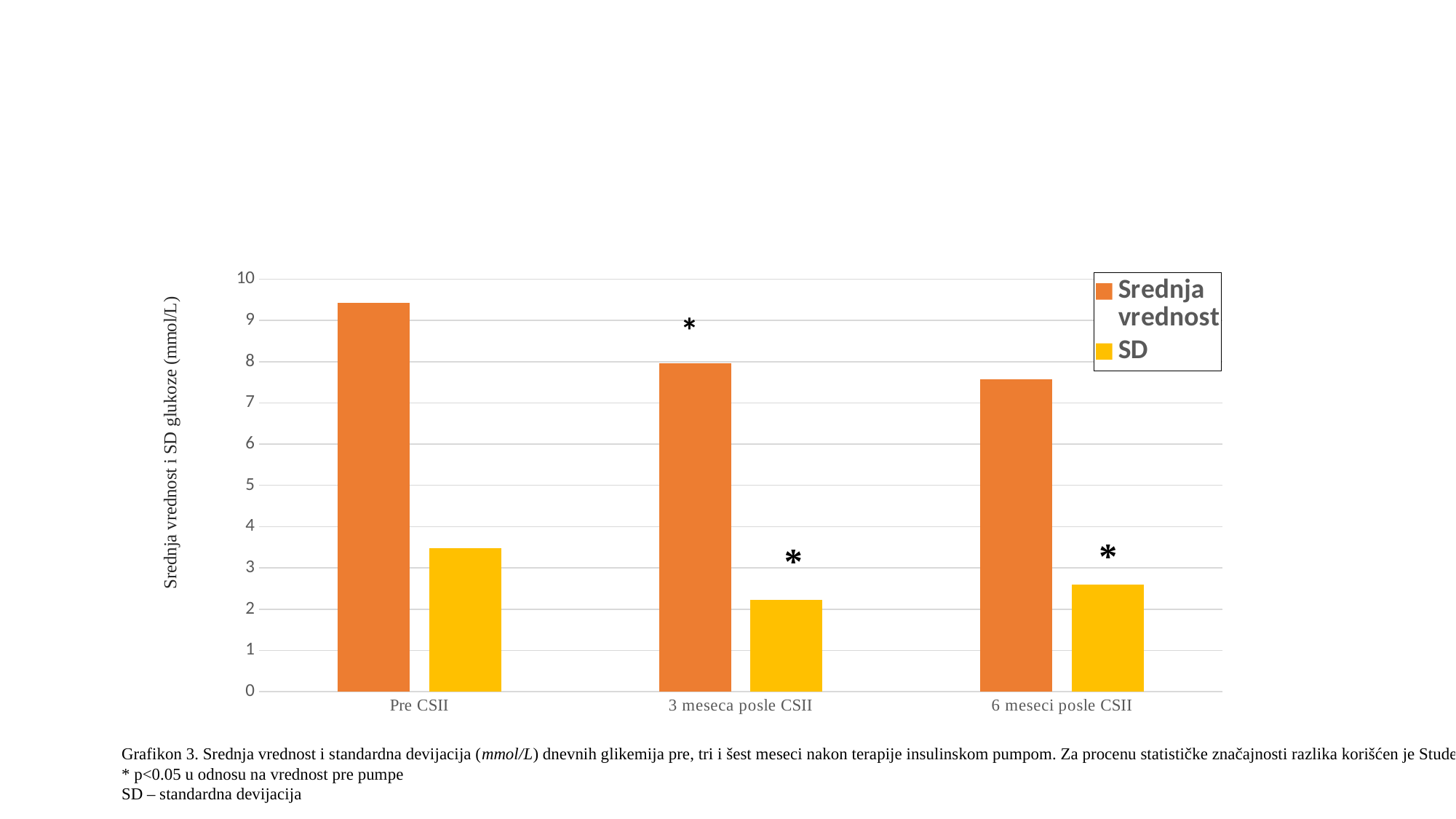
Which is larger, the SD for Pre CSII or the SD for 6 meseci posle CSII? Pre CSII How many series does the legend list? 2 What kind of chart is shown on the slide? bar chart What is the label of the vertical axis? Srednja vrednost i SD glukoze (mmol/L) Which category has the highest Srednja vrednost? Pre CSII Is the Srednja vrednost for Pre CSII greater or less than 9? greater Which category has the lowest Srednja vrednost? 6 meseci posle CSII Is the Srednja vrednost for 6 meseci posle CSII greater or less than 8? less Does the Srednja vrednost rise or fall from Pre CSII to 6 meseci posle CSII? fall How many categories are shown on the x axis? 3 Is the SD for 3 meseca posle CSII greater or less than 3? less Which category has the lowest SD? 3 meseca posle CSII